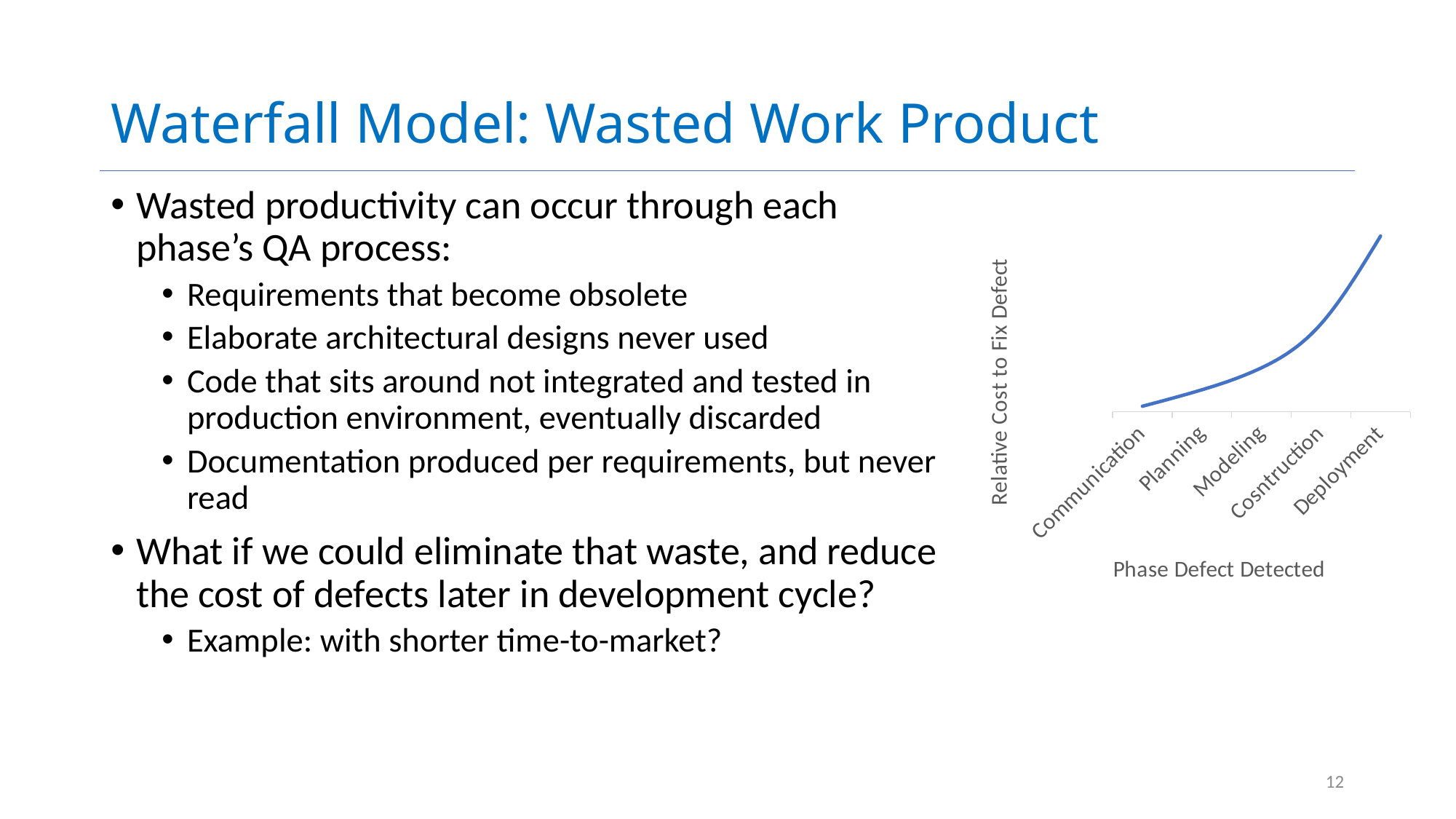
Which has a lower relative cost to fix a defect, Modeling or Deployment? Modeling Which phase comes last on the x axis of the chart? Deployment Which phase has the lowest relative cost to fix a defect? Communication Which phase has the highest relative cost to fix a defect? Deployment Which phase comes first on the x axis of the chart? Communication Which has a higher relative cost to fix a defect, Planning or Construction? Construction What is the label on the x axis of the chart? Phase Defect Detected What is the label on the y axis of the chart? Relative Cost to Fix Defect Does the relative cost to fix a defect rise or fall from Communication to Deployment? rise What kind of chart is shown on the slide? line chart How many phases are shown along the x axis of the chart? 5